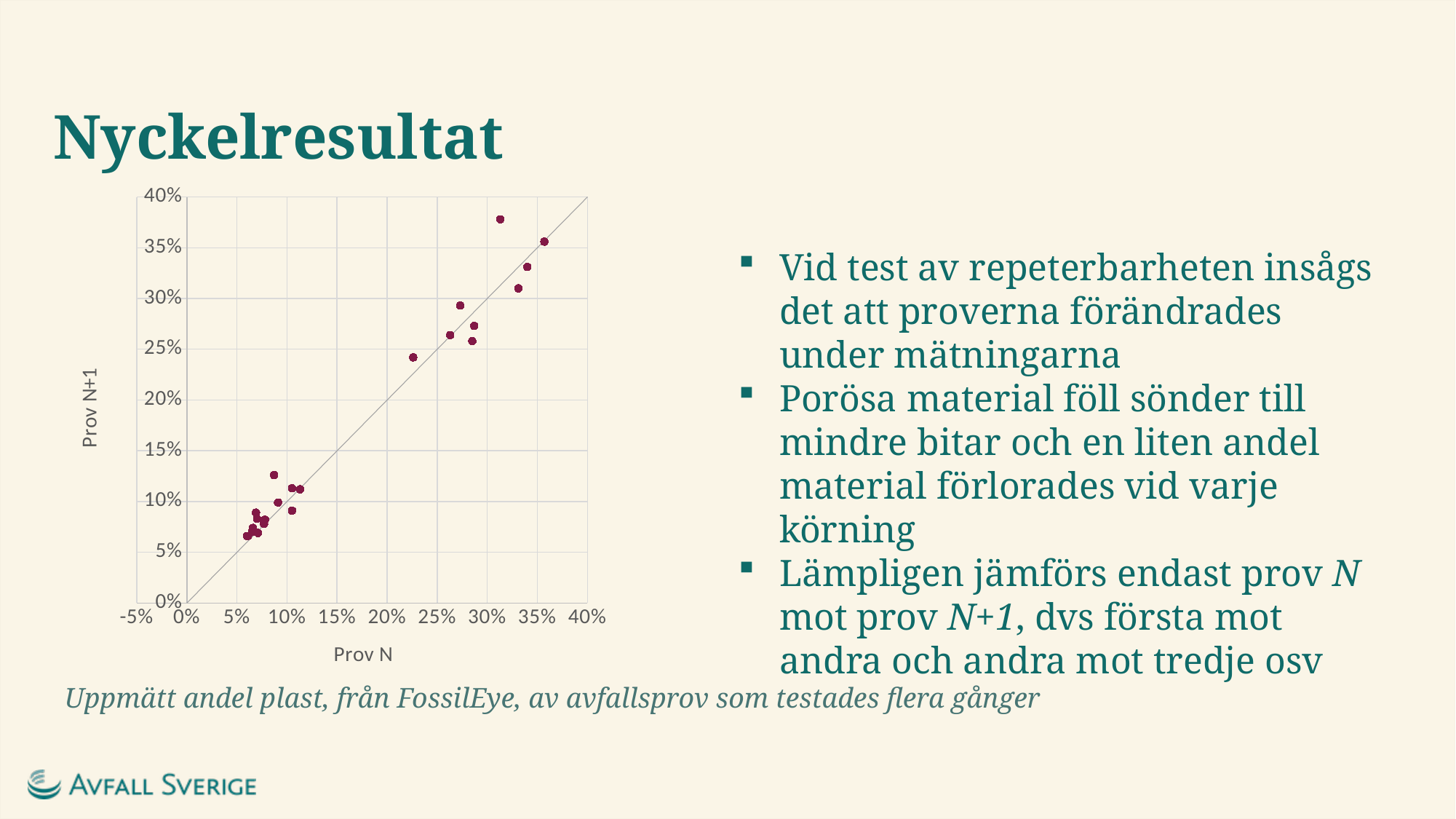
Is the highest Prov N+1 value plotted greater or less than 35%? greater Is the lowest Prov N+1 value plotted greater or less than 10%? less What is the title of the x axis of the chart? Prov N Is the lowest Prov N value plotted greater or less than 5%? greater What kind of chart is shown on the slide? Scatter chart Are there any points plotted with a Prov N value between 15% and 20%? No What is the title of the y axis of the chart? Prov N+1 Do the Prov N+1 values generally rise or fall as Prov N increases? Rise